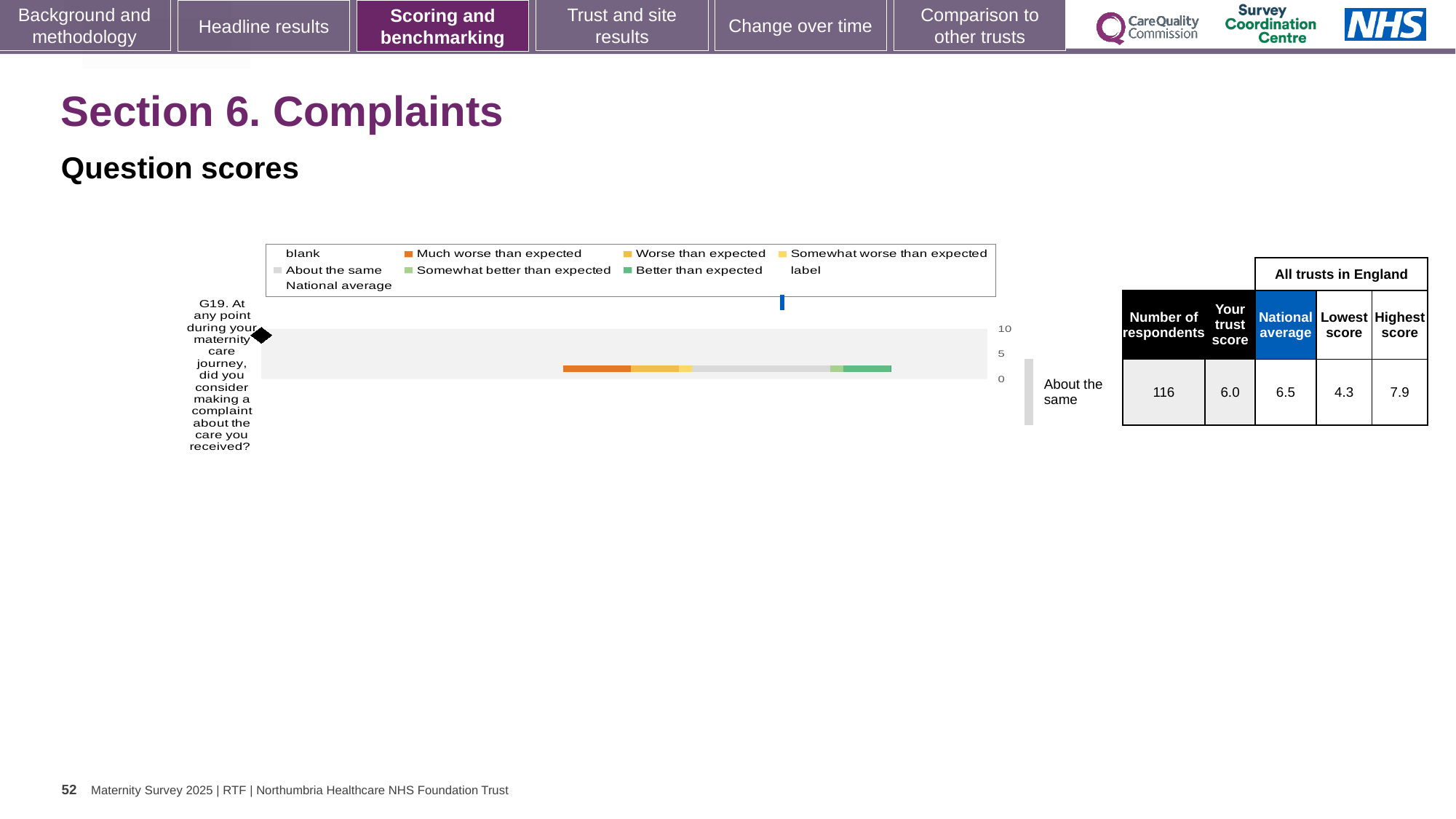
Which benchmark category is the trust's result for question G19 placed in? About the same What is the trust score for question G19? 6.0 What kind of chart is shown on the slide? bar chart Is the national average for question G19 greater or less than 5? greater How many respondents answered question G19? 116 What is the national average score for question G19? 6.5 Which survey question is plotted in the chart? G19. At any point during your maternity care journey, did you consider making a complaint about the care you received? Which is larger for question G19, the trust score or the national average? national average What is the difference between the highest score and the lowest score for question G19? 3.6 What is the highest score among all trusts in England for question G19? 7.9 What is the lowest score among all trusts in England for question G19? 4.3 How many survey questions are plotted in the chart? 1